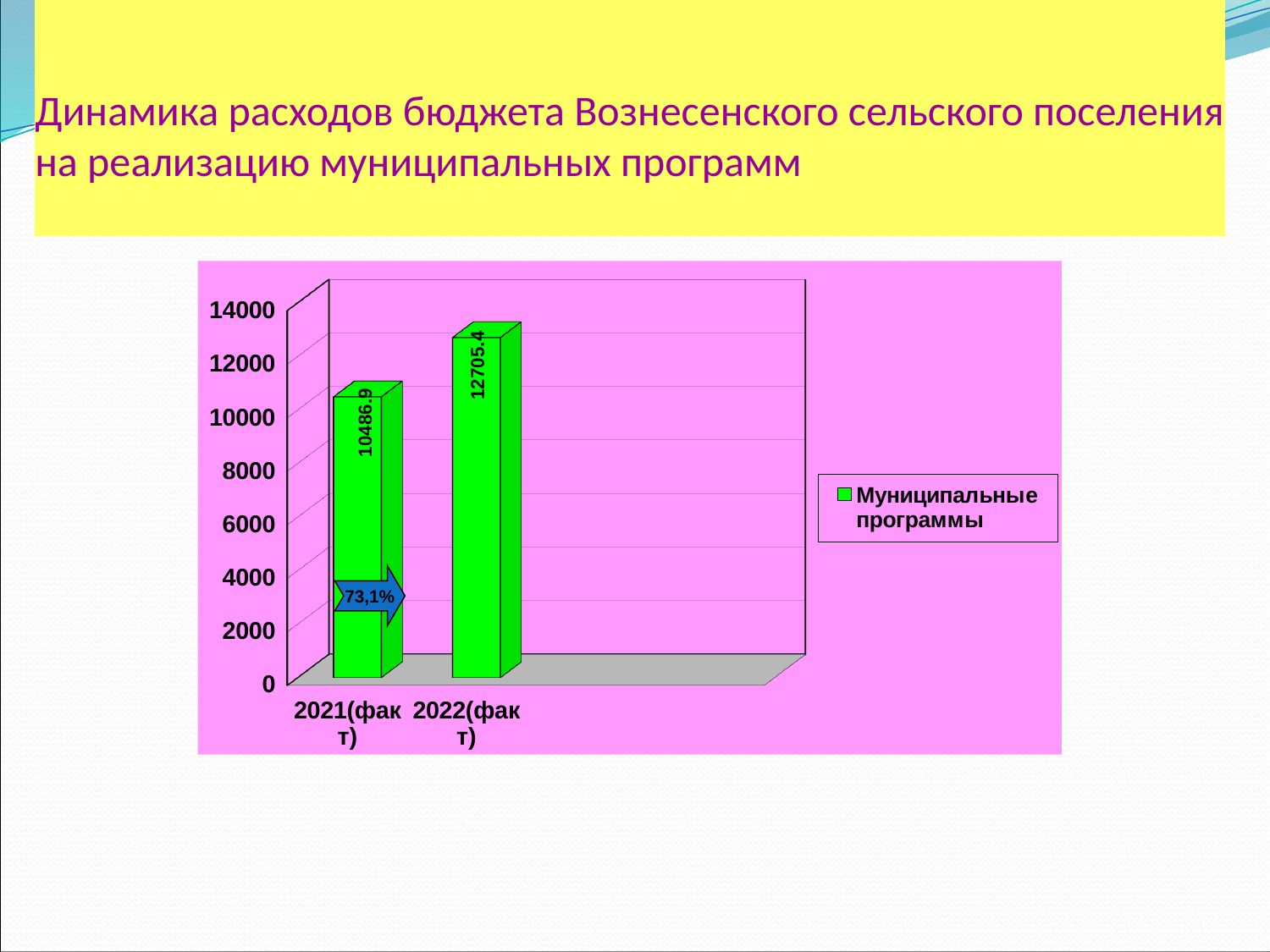
Which category has the lowest value? 2021(факт) What kind of chart is shown on the slide? bar chart What is the value for 2021(факт)? 10486.9 Is the value for 2021(факт) greater or less than 12000? less Which category has the highest value? 2022(факт) Is the value for 2022(факт) greater or less than 12000? greater What is the value for 2022(факт)? 12705.4 Which is larger, the value for 2021(факт) or the value for 2022(факт)? 2022(факт) How many categories are shown on the x axis? 2 What series name is shown in the legend? Муниципальные программы What is the difference between the values for 2022(факт) and 2021(факт)? 2218.5 How many series does the legend list? 1